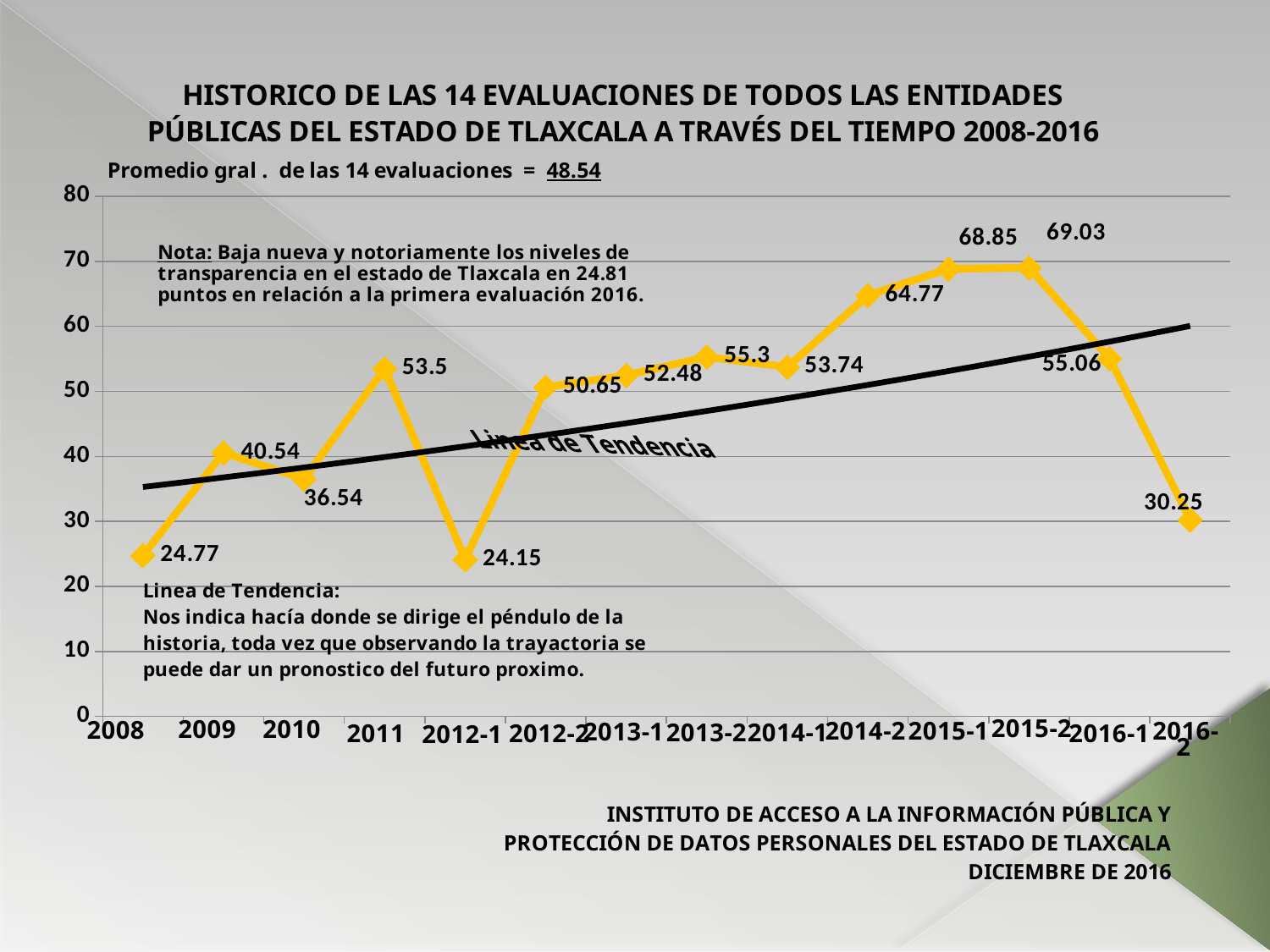
What is the value for 2008? 24.77 What is the general average (Promedio gral.) of the 14 evaluations stated on the slide? 48.54 Which evaluation period has the highest value? 2015-2 What is the difference between the values for 2015-2 and 2016-2? 38.78 What is the value for 2016-2? 30.25 Which evaluation period has the lowest value? 2012-1 What is the value for 2012-1? 24.15 What kind of chart is shown on the slide? Line chart What is the difference between the values for 2016-1 and 2016-2? 24.81 What is the value for 2015-2? 69.03 Which is larger, the value for 2011 or the value for 2013-2? 2013-2 How many evaluation periods are plotted on the x axis? 14